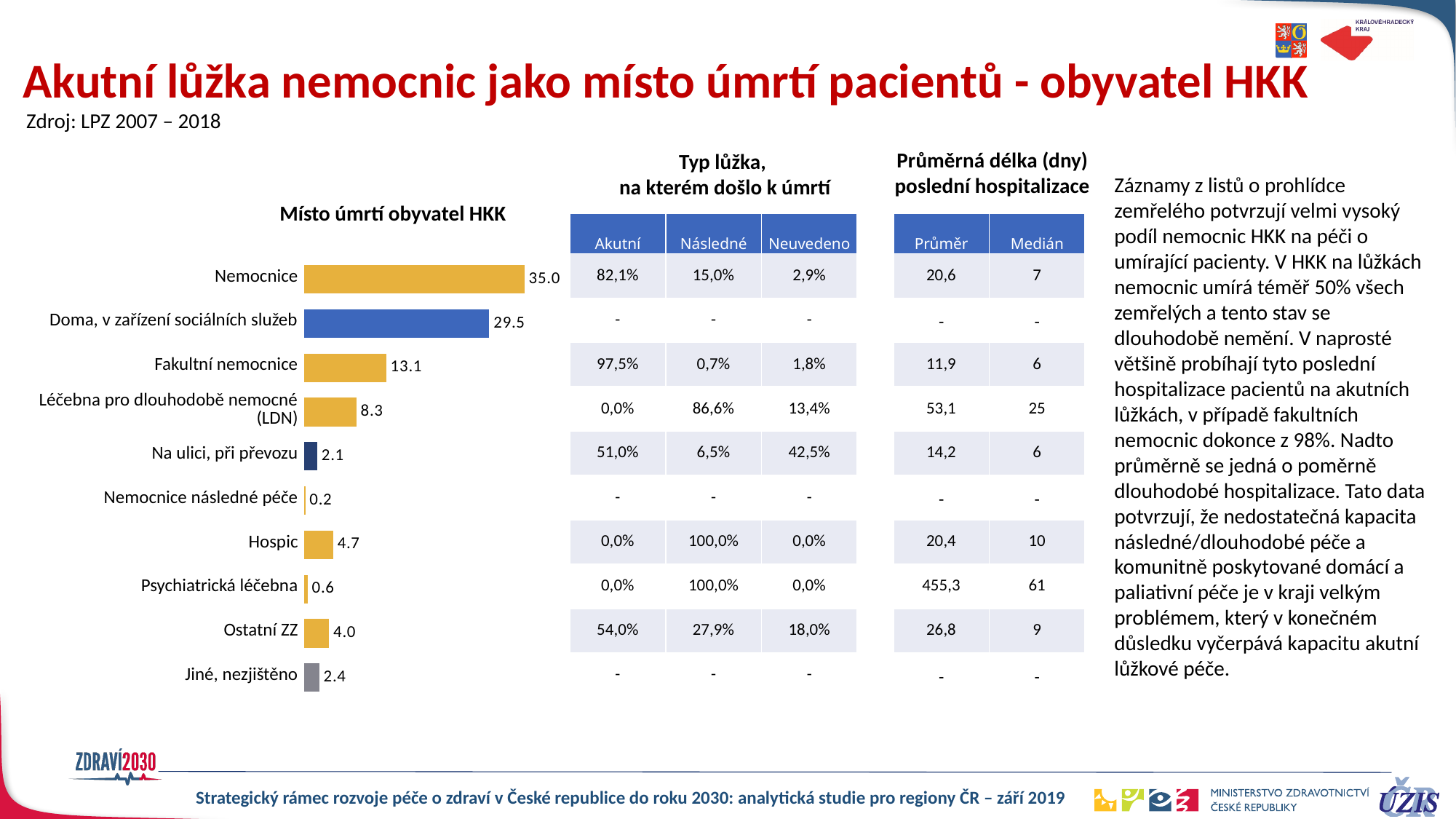
What is the value for Nemocnice in the chart 'Místo úmrtí obyvatel HKK'? 35.0 What is the value for Psychiatrická léčebna in the chart 'Místo úmrtí obyvatel HKK'? 0.6 Which category has the lowest value in the chart 'Místo úmrtí obyvatel HKK'? Nemocnice následné péče Which category has the highest value in the chart 'Místo úmrtí obyvatel HKK'? Nemocnice What is the value for Léčebna pro dlouhodobě nemocné (LDN) in the chart 'Místo úmrtí obyvatel HKK'? 8.3 What is the title of the bar chart on the slide? Místo úmrtí obyvatel HKK Which is larger in the chart 'Místo úmrtí obyvatel HKK': the value for Hospic or the value for Ostatní ZZ? Hospic What is the difference between the values for Fakultní nemocnice and Léčebna pro dlouhodobě nemocné (LDN) in the chart 'Místo úmrtí obyvatel HKK'? 4.8 What is the value for Hospic in the chart 'Místo úmrtí obyvatel HKK'? 4.7 What is the difference between the values for Nemocnice and Doma, v zařízení sociálních služeb in the chart 'Místo úmrtí obyvatel HKK'? 5.5 How many categories are shown in the chart 'Místo úmrtí obyvatel HKK'? 10 What type of chart is 'Místo úmrtí obyvatel HKK'? Bar chart